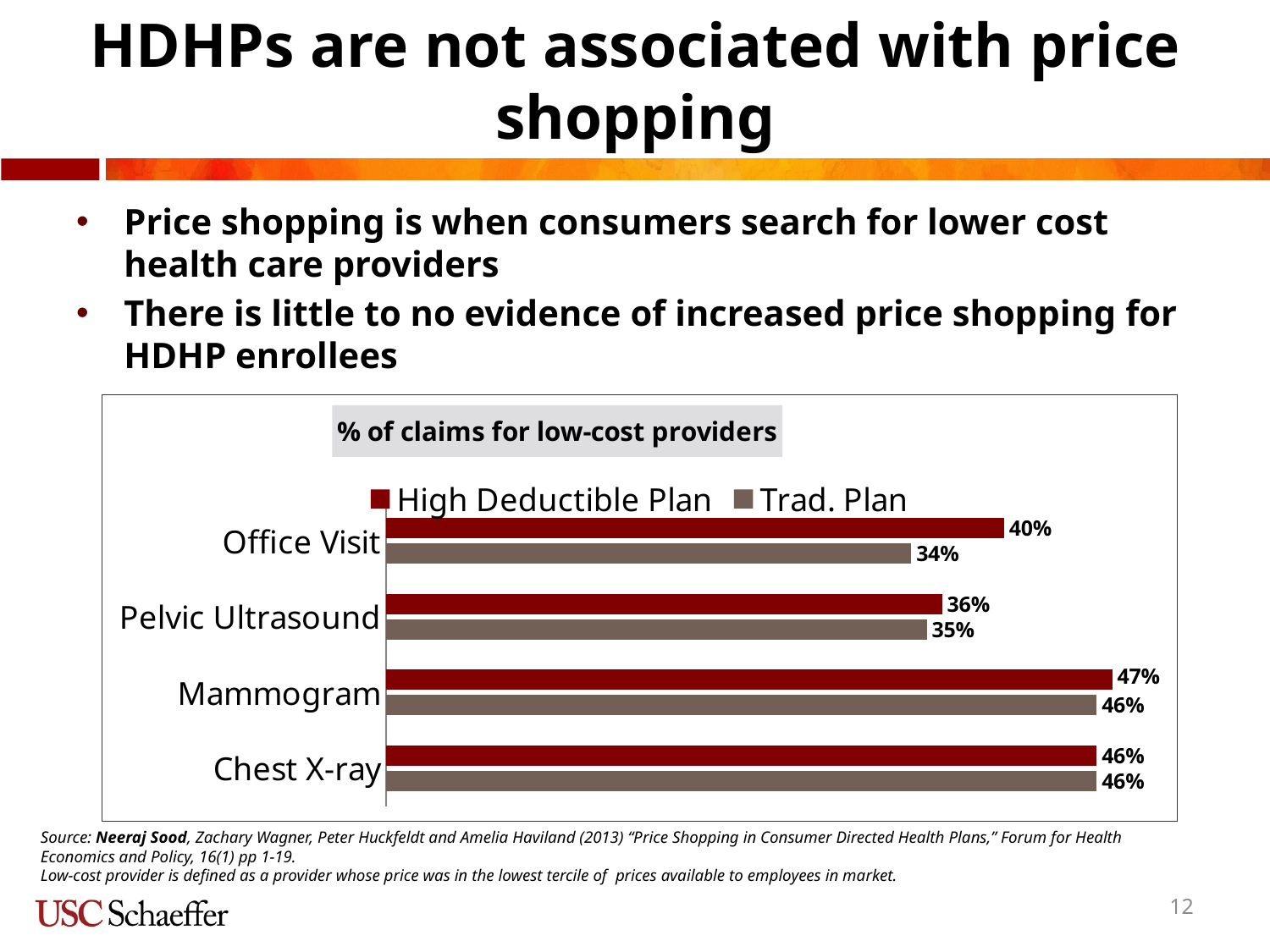
What is the Trad. Plan value for Pelvic Ultrasound? 35% Which category has the highest High Deductible Plan value? Mammogram What is the title of the chart? % of claims for low-cost providers What is the High Deductible Plan value for Office Visit? 40% How many series does the legend list? 2 What kind of chart is shown on the slide? Bar chart Which category has the lowest Trad. Plan value? Office Visit What is the Trad. Plan value for Mammogram? 46% Which series is shown in dark red? High Deductible Plan How many categories are shown on the chart? 4 For Pelvic Ultrasound, which is larger: the High Deductible Plan value or the Trad. Plan value? High Deductible Plan What is the difference between the High Deductible Plan and Trad. Plan values for Office Visit? 6%